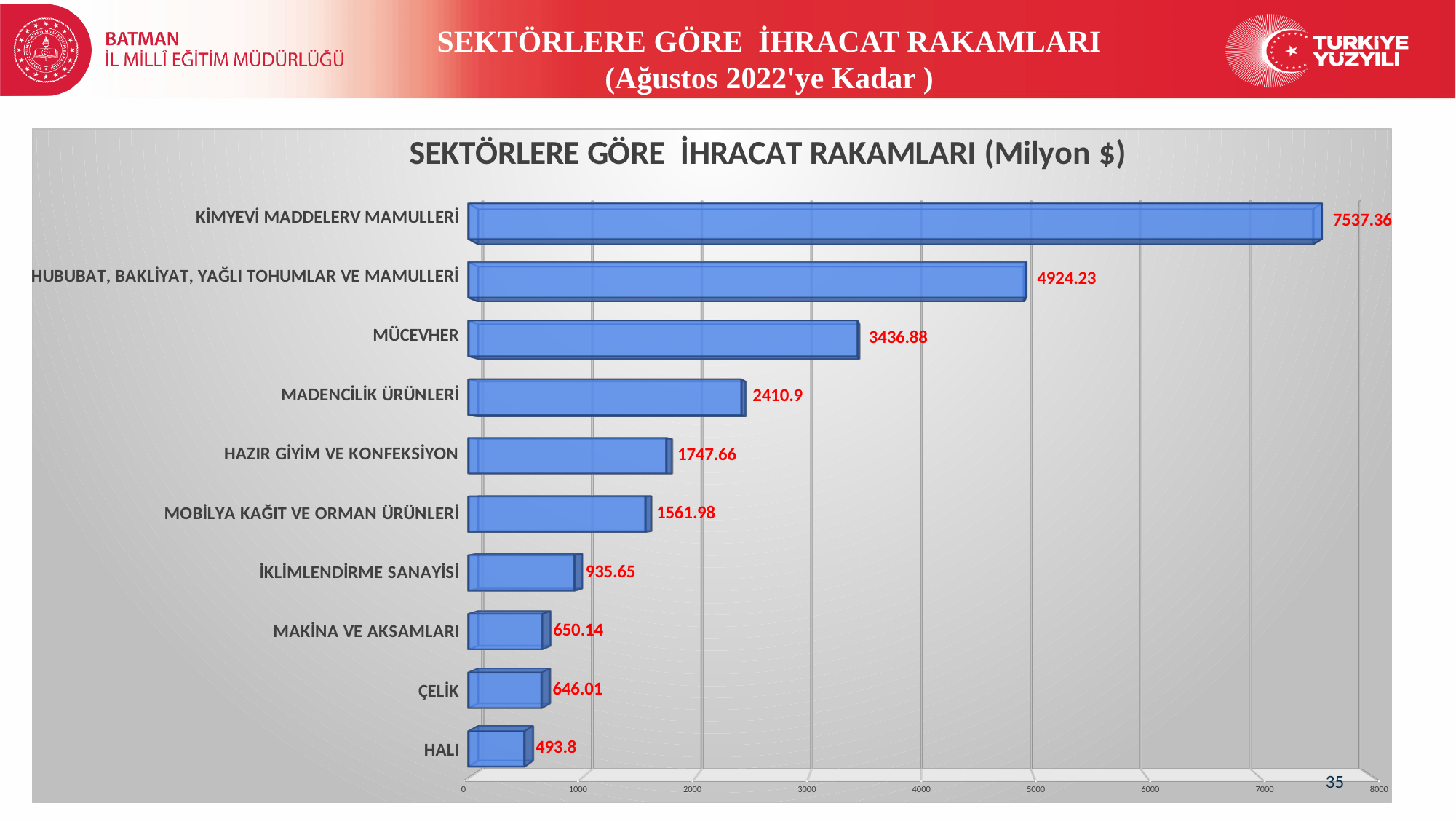
What is the difference between the export values of KİMYEVİ MADDELERV MAMULLERİ and HUBUBAT, BAKLİYAT, YAĞLI TOHUMLAR VE MAMULLERİ? 2613.13 What is the export value for HALI? 493.8 Which has a larger export value, MÜCEVHER or MADENCİLİK ÜRÜNLERİ? MÜCEVHER What is the difference between the export values of HAZIR GİYİM VE KONFEKSİYON and MOBİLYA KAĞIT VE ORMAN ÜRÜNLERİ? 185.68 How many sectors are shown in the chart? 10 Is the value for MÜCEVHER greater or less than 3000? greater What unit is given in the chart title for the export figures? Milyon $ What is the export value for MÜCEVHER? 3436.88 What is the export value for İKLİMLENDİRME SANAYİSİ? 935.65 Which sector has the lowest export value? HALI Which sector has the highest export value? KİMYEVİ MADDELERV MAMULLERİ What kind of chart is shown on the slide? bar chart